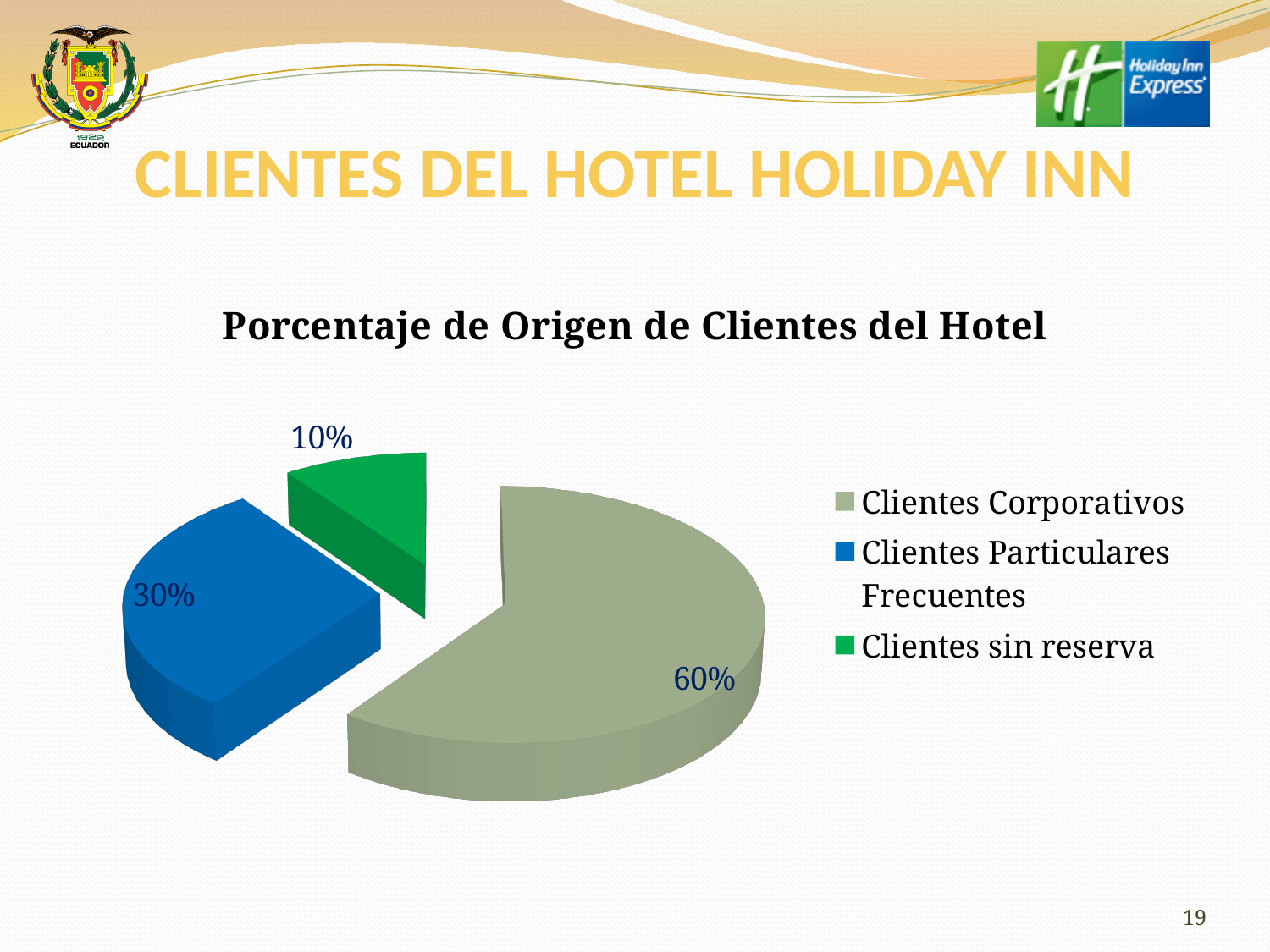
How many slices does the pie chart have? 3 What kind of chart is shown on the slide? Pie chart Which is larger, the share for Clientes Particulares Frecuentes or the share for Clientes sin reserva? Clientes Particulares Frecuentes Which category has the largest share of the pie? Clientes Corporativos What is the difference in percentage points between Clientes Corporativos and Clientes Particulares Frecuentes? 30 What percentage of the pie is Clientes sin reserva? 10% Which category has the smallest share of the pie? Clientes sin reserva What is the title of the chart? Porcentaje de Origen de Clientes del Hotel What colour is the slice for Clientes sin reserva? Green What percentage of the pie is Clientes Particulares Frecuentes? 30% What percentage of the pie is Clientes Corporativos? 60% What is the difference in percentage points between Clientes Particulares Frecuentes and Clientes sin reserva? 20